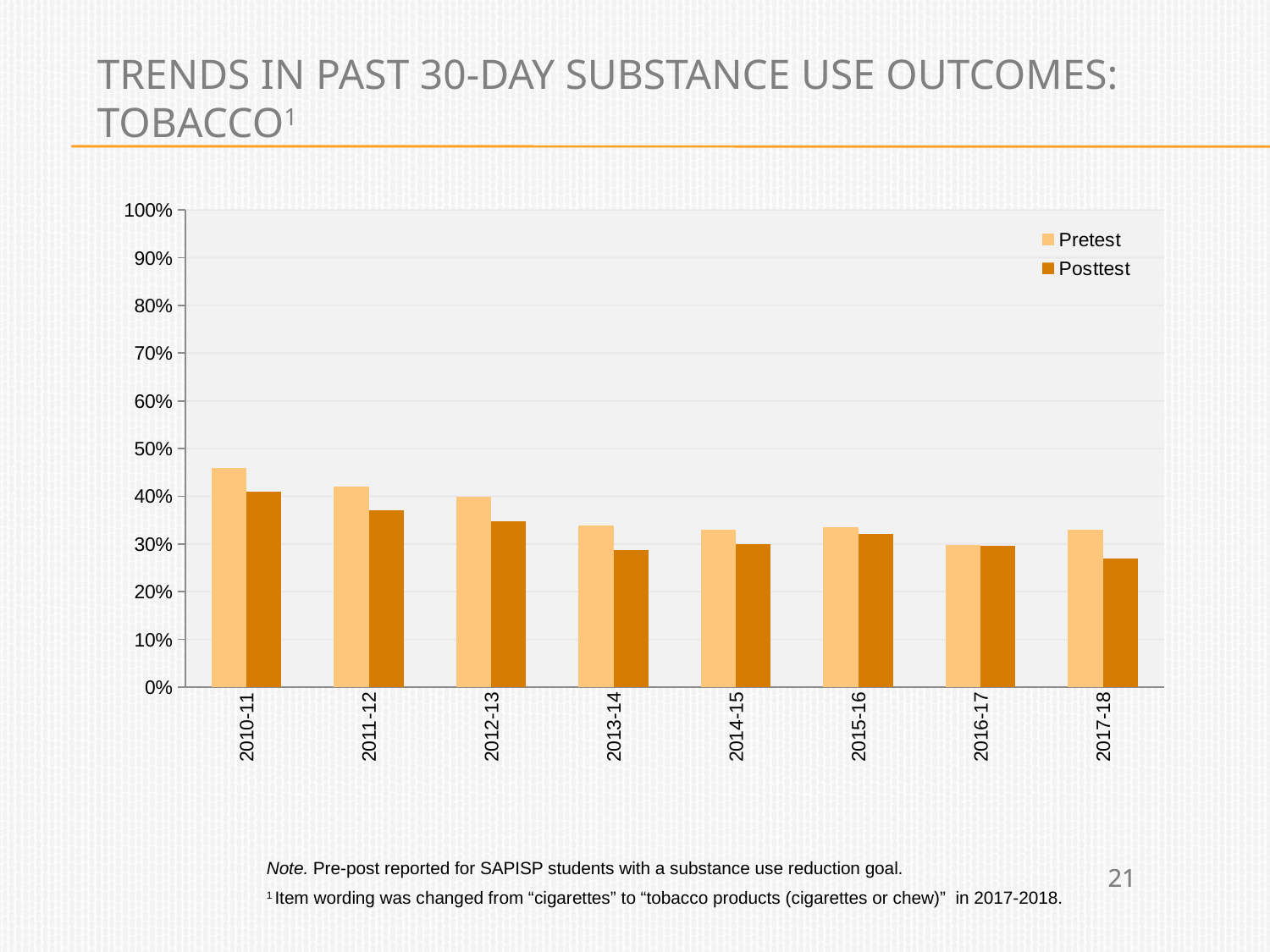
Which school year has the highest Posttest value? 2010-11 How many series does the legend list? 2 Is the Pretest value for 2010-11 greater or less than 40%? greater Do the Pretest values generally rise or fall from 2010-11 to 2016-17? fall Is the Posttest value for 2017-18 greater or less than 30%? less Which school year has the lowest Pretest value? 2016-17 What are the two legend entries of the chart? Pretest and Posttest What kind of chart is shown on the slide? bar chart For 2017-18, which is larger, the Pretest or the Posttest value? Pretest Is the Posttest value for 2012-13 greater or less than 40%? less How many school years are shown on the x axis? 8 Which school year has the highest Pretest value? 2010-11